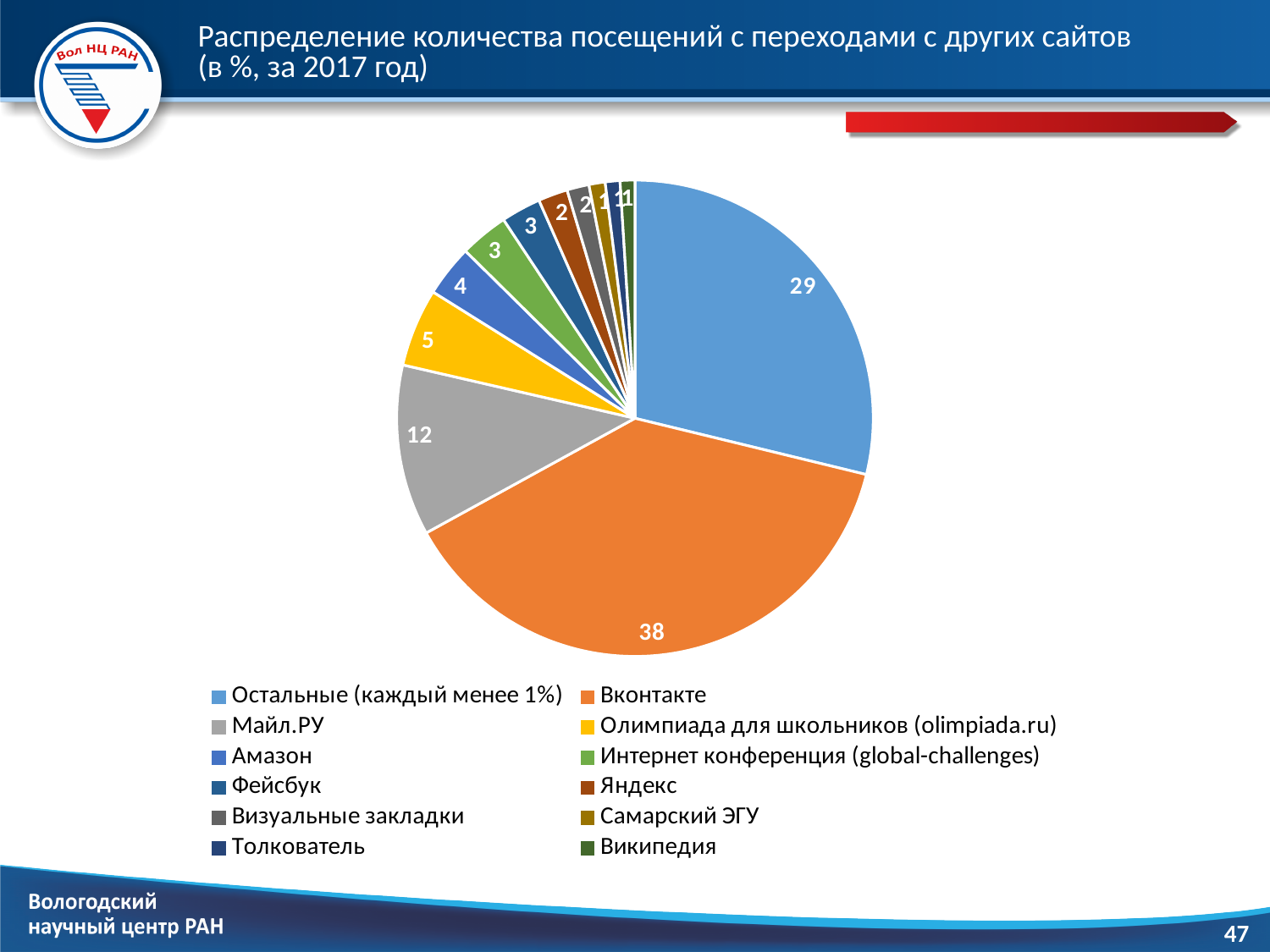
What is the difference between the values for Вконтакте and Остальные (каждый менее 1%)? 9 What is the value for Остальные (каждый менее 1%)? 29 What is the value for Майл.РУ? 12 What is the title of the chart? Распределение количества посещений с переходами с других сайтов (в %, за 2017 год) What is the difference between the values for Майл.РУ and Амазон? 8 What kind of chart is shown on the slide? pie chart Which category has the largest slice of the pie? Вконтакте What is the value for Амазон? 4 How many categories does the legend list? 12 Which is larger, the value for Майл.РУ or the value for Олимпиада для школьников (olimpiada.ru)? Майл.РУ What is the value for Вконтакте? 38 What is the value for Олимпиада для школьников (olimpiada.ru)? 5